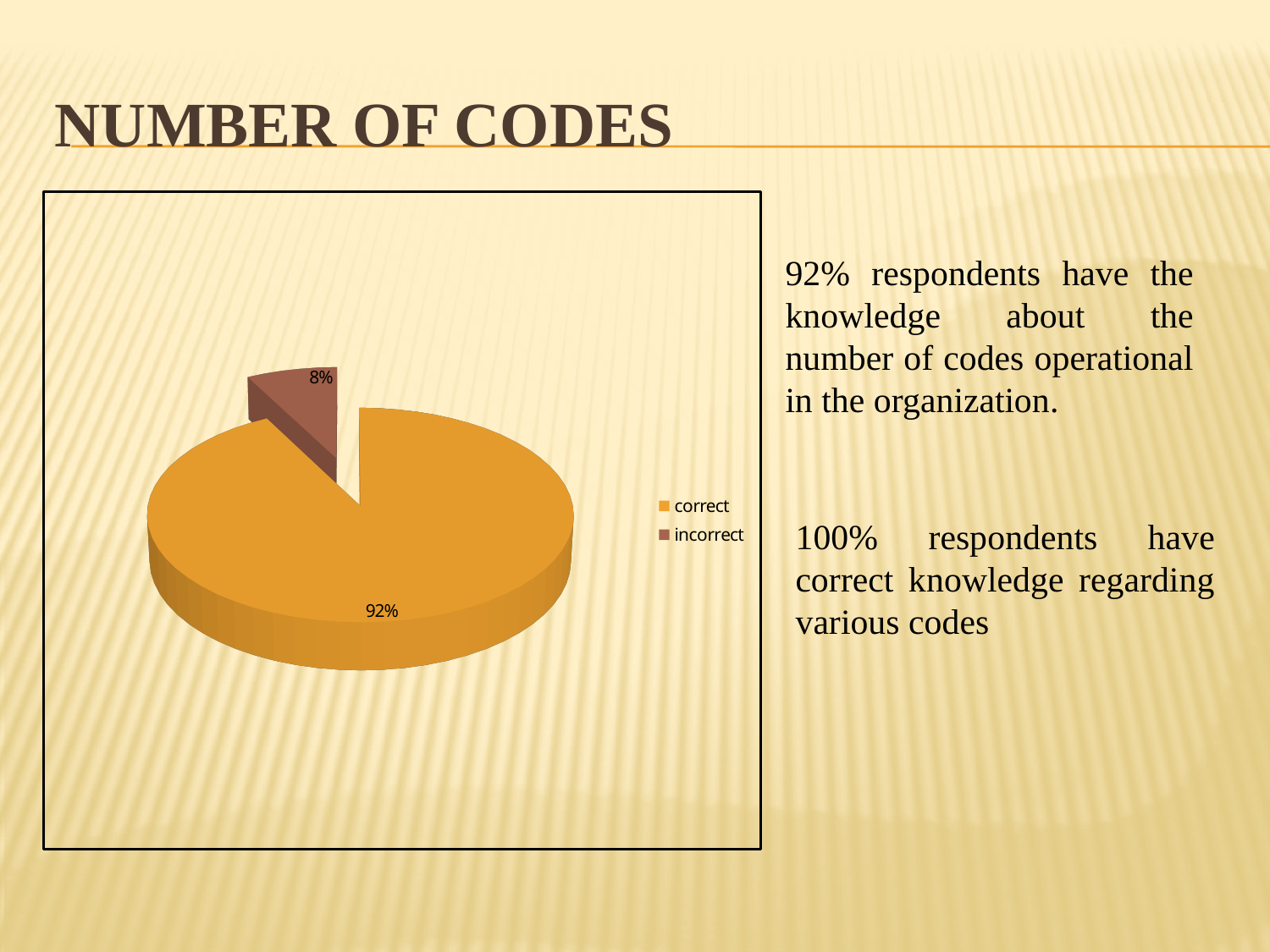
What colour is the "incorrect" slice in the pie chart? brown What share of the pie is labelled "incorrect"? 8% What share of the pie is labelled "correct"? 92% What colour is the "correct" slice in the pie chart? orange Which slice of the pie is the smallest? incorrect How many slices does the pie chart have? 2 What is the total of the two slices shown in the pie chart? 100% What is the difference in percentage points between the "correct" and "incorrect" slices? 84 Which is larger, the "correct" slice or the "incorrect" slice? correct How many entries does the legend list? 2 Which slice of the pie is the largest? correct What kind of chart is shown on the slide? pie chart